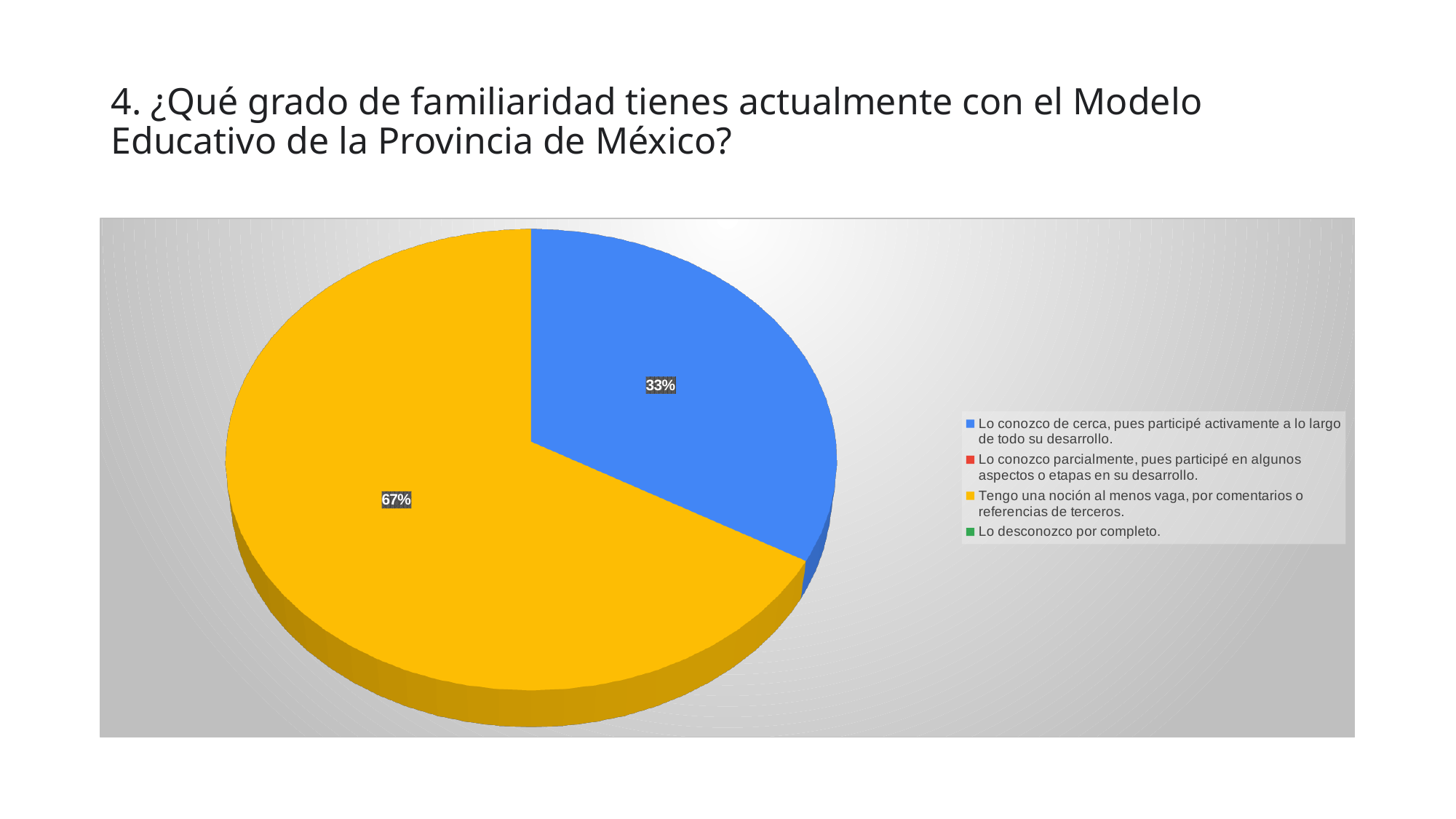
Which is larger: the slice for 'Lo conozco de cerca, pues participé activamente a lo largo de todo su desarrollo.' or the slice for 'Tengo una noción al menos vaga, por comentarios o referencias de terceros.'? Tengo una noción al menos vaga, por comentarios o referencias de terceros. What colour is the slice labelled 33%? blue What colour is the slice labelled 67%? yellow What is the difference in percentage points between the 67% slice and the 33% slice? 34 What share of the pie does the slice 'Tengo una noción al menos vaga, por comentarios o referencias de terceros.' represent? 67% How many slices are visible in the pie? 2 What share of the pie does the slice 'Lo conozco de cerca, pues participé activamente a lo largo de todo su desarrollo.' represent? 33% Which category has the largest slice of the pie? Tengo una noción al menos vaga, por comentarios o referencias de terceros. What kind of chart is shown on the slide? pie chart How many entries does the legend list? 4